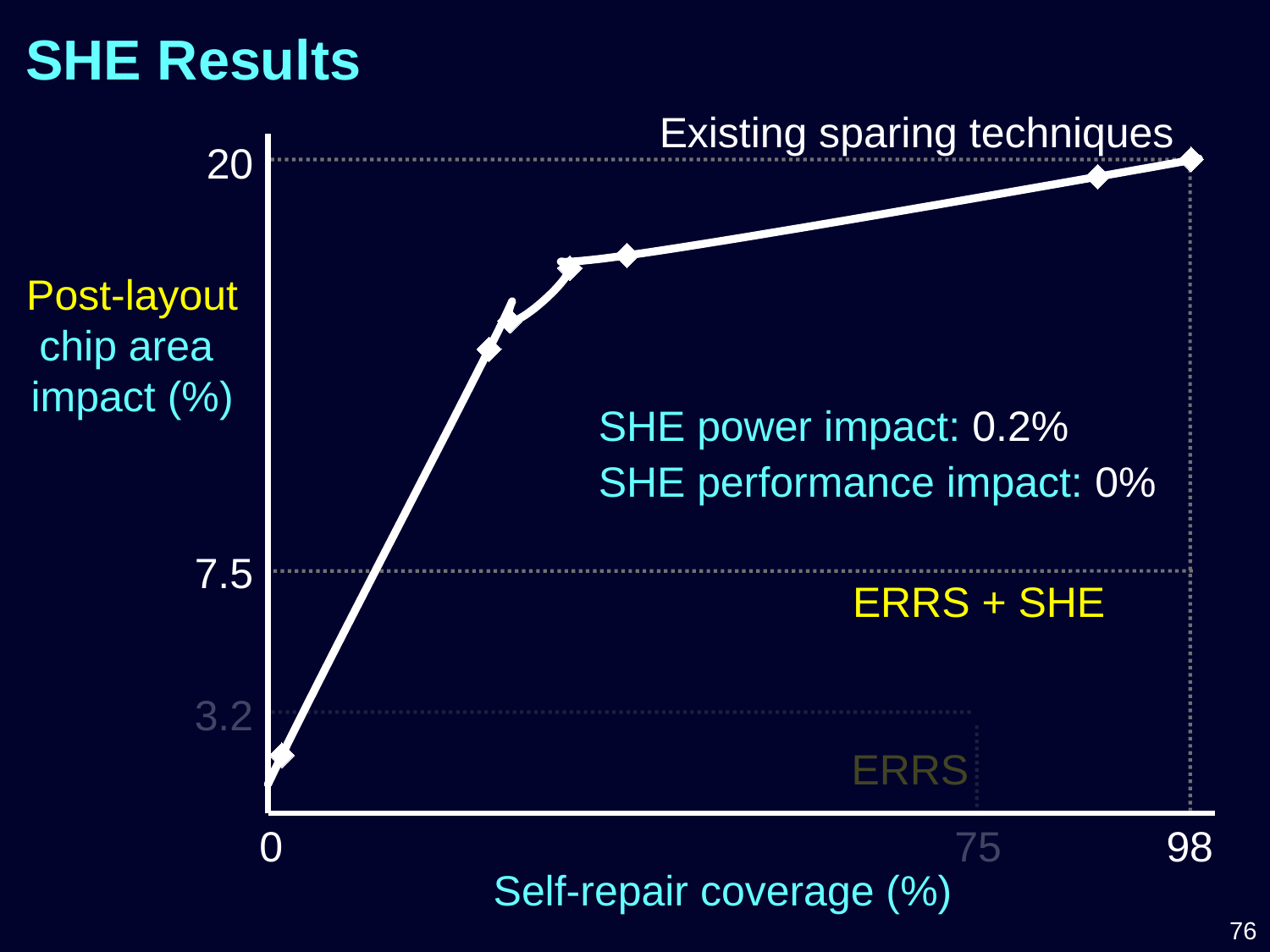
Is the chip area impact at 75% self-repair coverage greater or less than 7.5? greater What post-layout chip area impact (%) is marked for existing sparing techniques? 20 Is the chip area impact at 0% self-repair coverage greater or less than 3.2? less What kind of chart is shown on the slide? line chart Does the post-layout chip area impact rise or fall as self-repair coverage increases? rise Is the chip area impact at 98% self-repair coverage greater or less than 7.5? greater What post-layout chip area impact (%) is marked for ERRS? 3.2 What is the title of the y axis? Post-layout chip area impact (%) What self-repair coverage (%) does ERRS + SHE reach? 98 What self-repair coverage (%) does ERRS reach? 75 What post-layout chip area impact (%) is marked for ERRS + SHE? 7.5 What is the title of the x axis? Self-repair coverage (%)